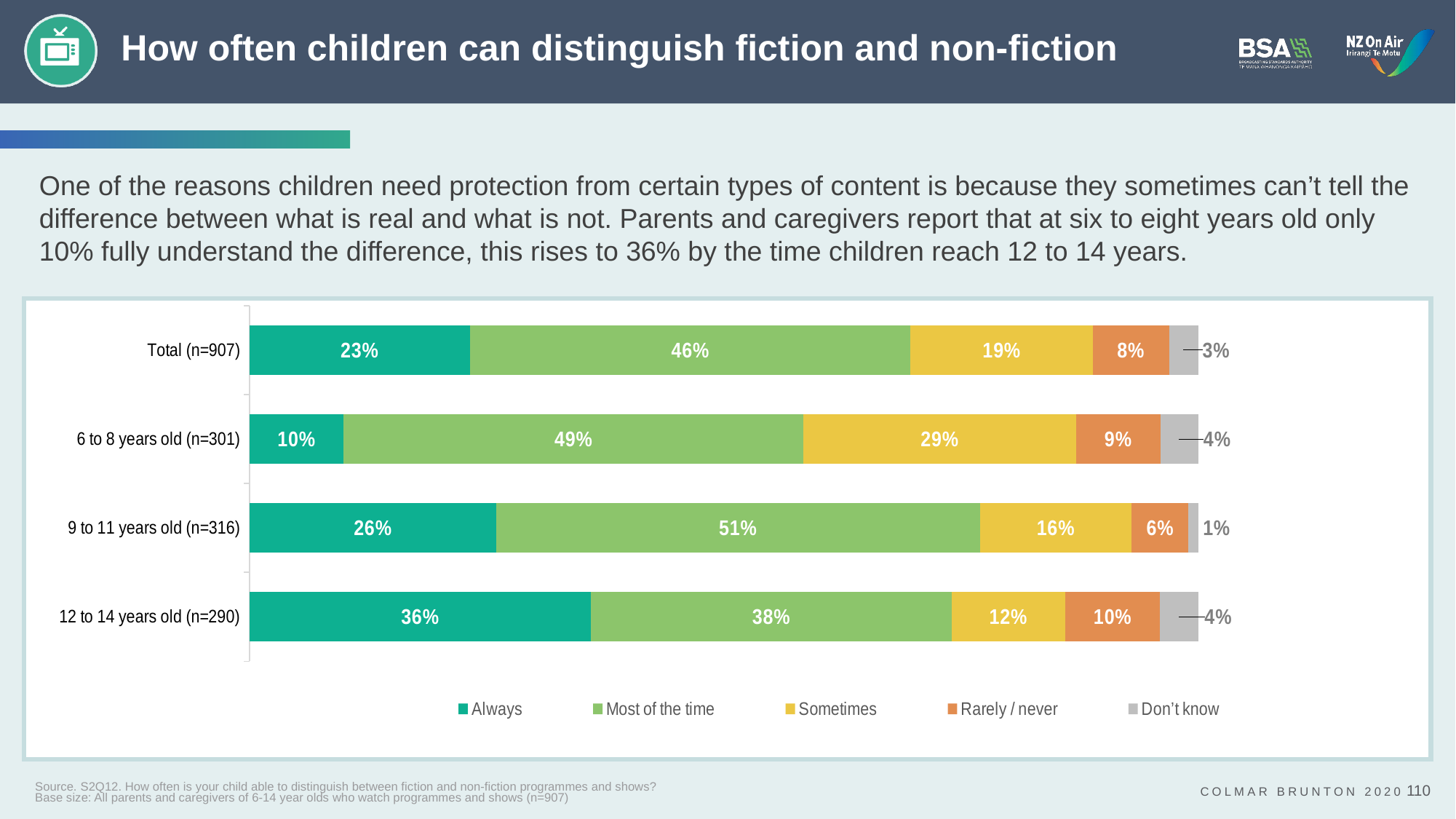
What is the 'Sometimes' value for the Total group? 19% What kind of chart is shown on the slide? Stacked bar chart What is the base size (n) for the 9 to 11 years old group? 316 What is the 'Rarely / never' value for 12 to 14 years old? 10% How many age-group bars (including Total) are shown in the chart? 4 What is the 'Most of the time' value for 9 to 11 years old? 51% What percentage of parents of 6 to 8 year olds say their child can 'Always' distinguish fiction and non-fiction? 10% Which is larger: the 'Sometimes' value for 6 to 8 years old or for 9 to 11 years old? 6 to 8 years old What is the difference between the 'Always' values for 12 to 14 years old and 6 to 8 years old? 26% How many series does the legend list? 5 Which age group has the lowest 'Don't know' value? 9 to 11 years old Which age group has the highest 'Always' value? 12 to 14 years old